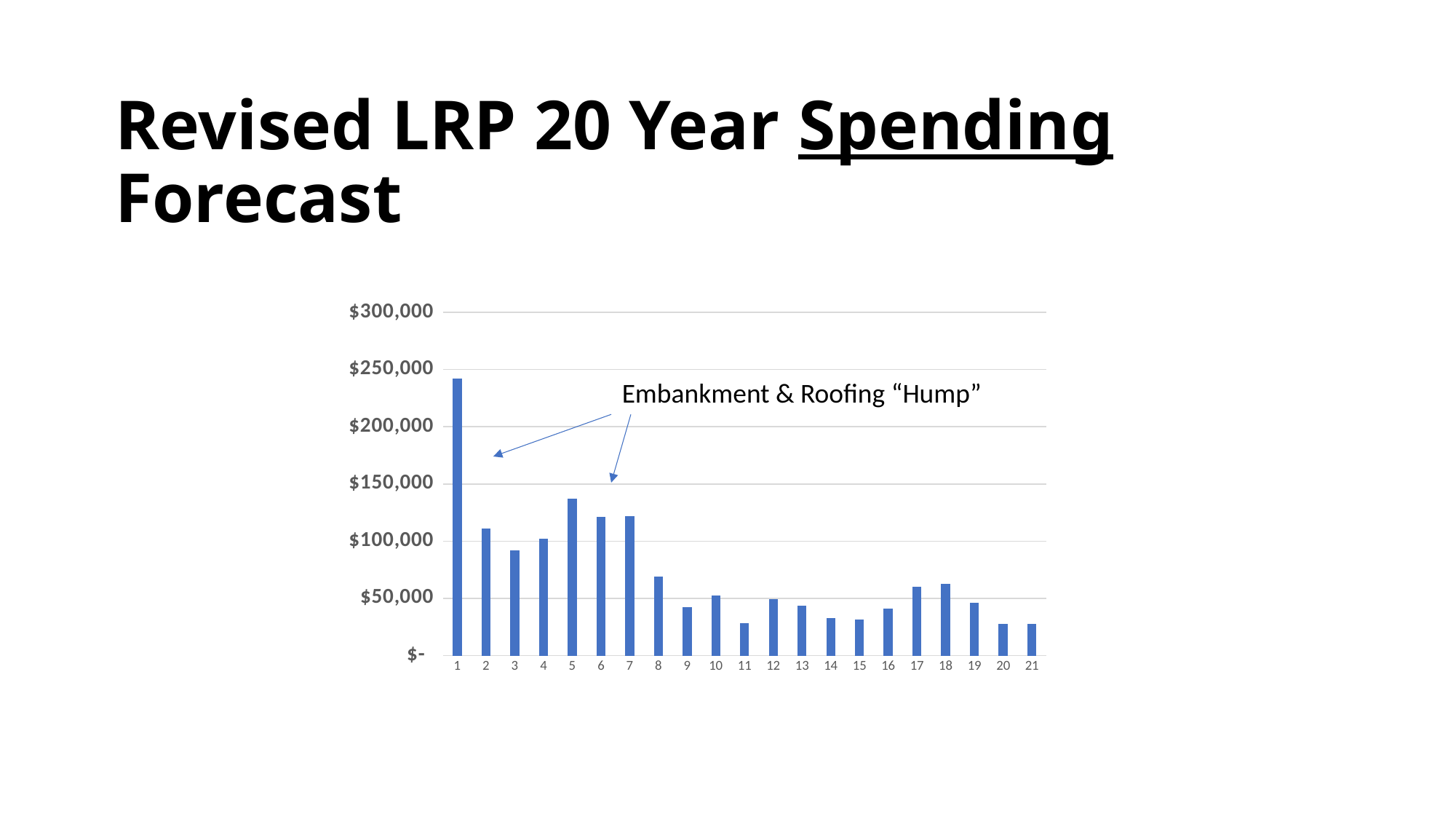
Which year has the highest spending on the chart? 1 What text does the annotation with arrows on the chart say? Embankment & Roofing "Hump" Is the value for year 5 greater or less than $150,000? less Which is larger, the value for year 17 or the value for year 9? Year 17 Which is larger, the value for year 5 or the value for year 2? Year 5 Is the value for year 8 greater or less than $50,000? greater Do the values rise or fall from year 1 to year 3? Fall Is the value for year 3 greater or less than $100,000? less How many bars (years) are plotted on the chart? 21 What kind of chart is shown on the slide? Bar chart